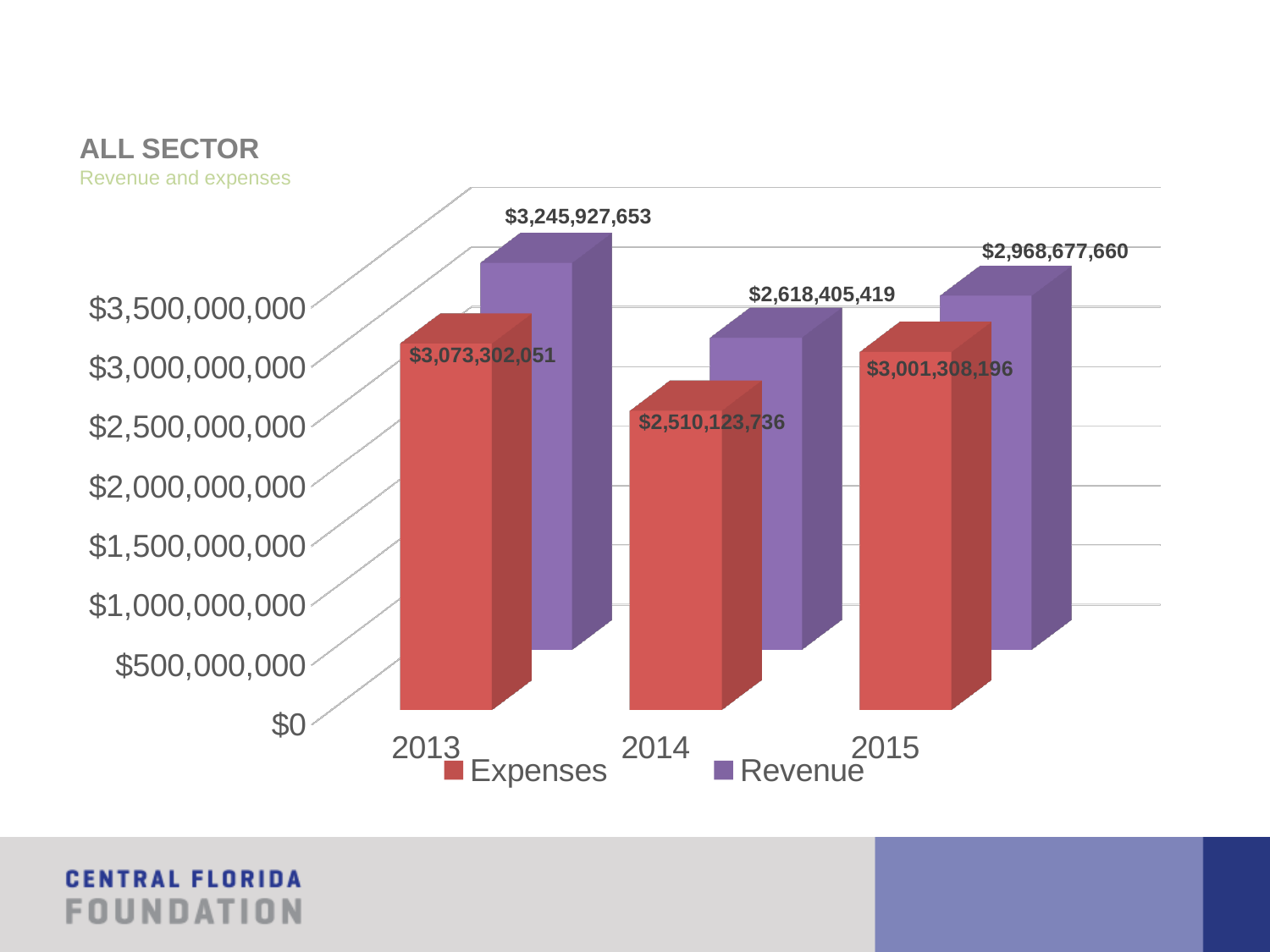
Which year has the highest Revenue? 2013 What is the Expenses value for 2015? $3,001,308,196 How many series does the legend list? 2 What kind of chart is shown on the slide? Bar chart What is the difference between Revenue and Expenses in 2014? $108,281,683 What is the Revenue value for 2013? $3,245,927,653 In 2015, which is larger, Expenses or Revenue? Expenses Which year has the lowest Expenses? 2014 How many years are shown on the x axis? 3 What is the Revenue value for 2015? $2,968,677,660 What is the Expenses value for 2014? $2,510,123,736 What is the difference between Revenue and Expenses in 2013? $172,625,602